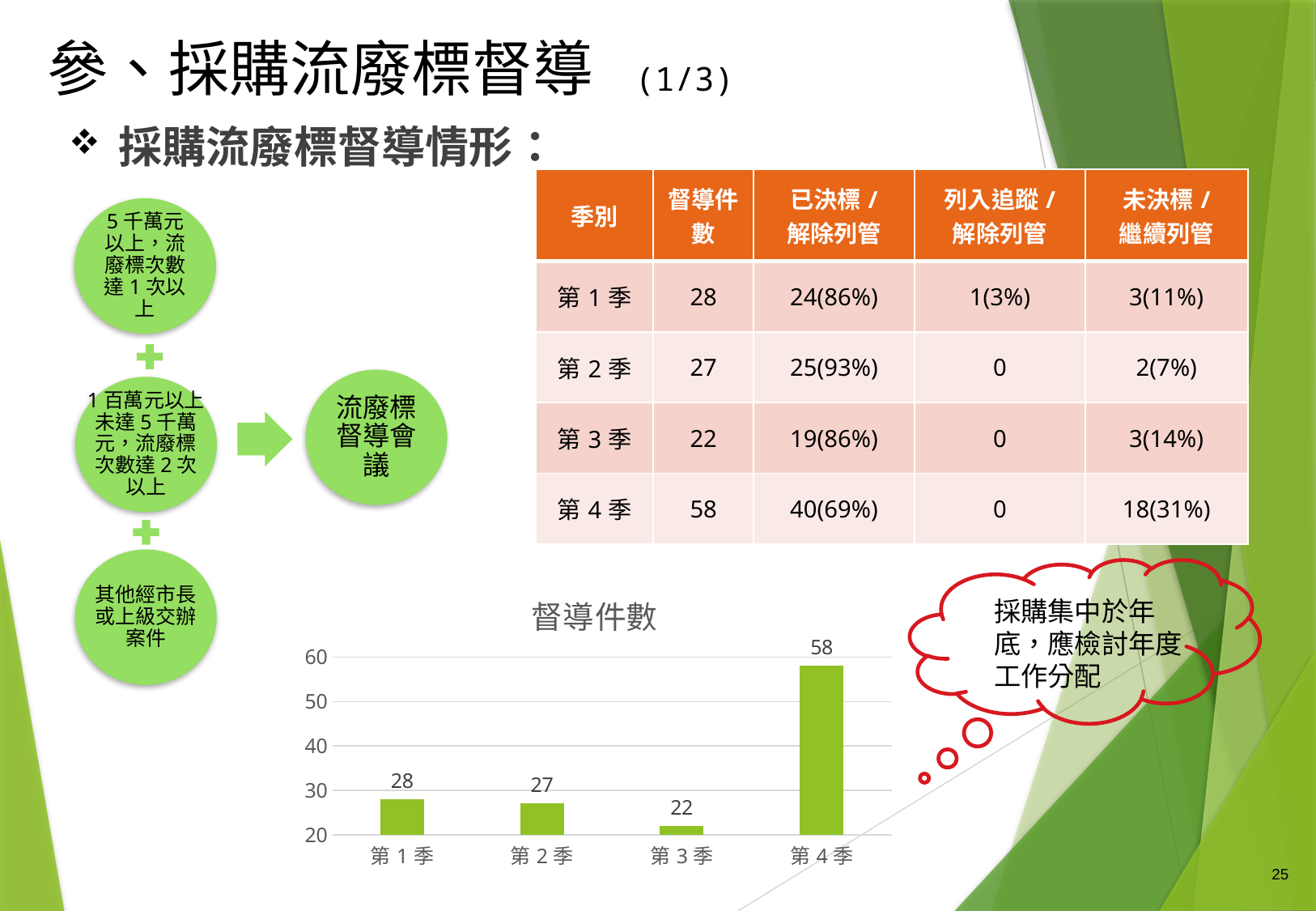
What is the value for 第 4 季 in the 督導件數 chart? 58 Which quarter has the lowest value in the 督導件數 chart? 第 3 季 What is the difference between the values for 第 2 季 and 第 3 季 in the 督導件數 chart? 5 What is the value for 第 3 季 in the 督導件數 chart? 22 What kind of chart is the 督導件數 chart? bar chart Which is larger in the 督導件數 chart, 第 1 季 or 第 2 季? 第 1 季 How many quarters are shown in the 督導件數 chart? 4 Which quarter has the highest value in the 督導件數 chart? 第 4 季 What is the difference between the values for 第 4 季 and 第 1 季 in the 督導件數 chart? 30 Is the value for 第 4 季 in the 督導件數 chart greater or less than 50? greater What is the value for 第 1 季 in the 督導件數 chart? 28 What is the title of the chart on the slide? 督導件數